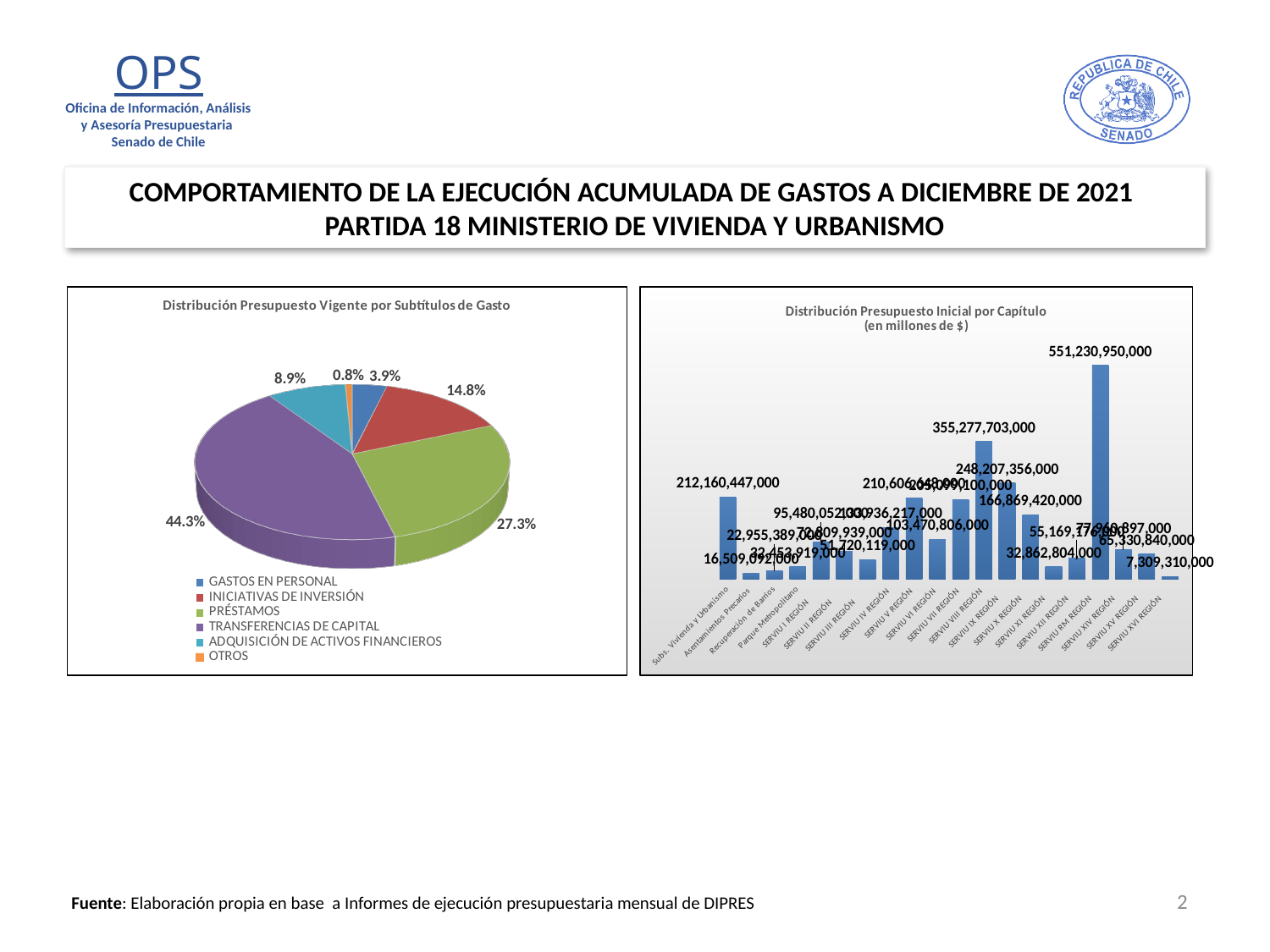
In the bar chart 'Distribución Presupuesto Inicial por Capítulo', what is the value of the highest bar? 551,230,950,000 In the pie chart 'Distribución Presupuesto Vigente por Subtítulos de Gasto', which is larger: GASTOS EN PERSONAL or ADQUISICIÓN DE ACTIVOS FINANCIEROS? ADQUISICIÓN DE ACTIVOS FINANCIEROS What kind of chart is 'Distribución Presupuesto Inicial por Capítulo'? Bar chart In the pie chart 'Distribución Presupuesto Vigente por Subtítulos de Gasto', what share does PRÉSTAMOS have? 27.3% In the pie chart 'Distribución Presupuesto Vigente por Subtítulos de Gasto', which category has the smallest share? OTROS In the pie chart 'Distribución Presupuesto Vigente por Subtítulos de Gasto', what share does TRANSFERENCIAS DE CAPITAL have? 44.3% In the pie chart 'Distribución Presupuesto Vigente por Subtítulos de Gasto', which category has the largest share? TRANSFERENCIAS DE CAPITAL In the pie chart 'Distribución Presupuesto Vigente por Subtítulos de Gasto', what is the difference in percentage points between PRÉSTAMOS and INICIATIVAS DE INVERSIÓN? 12.5 In the pie chart 'Distribución Presupuesto Vigente por Subtítulos de Gasto', how many categories does the legend list? 6 In the pie chart 'Distribución Presupuesto Vigente por Subtítulos de Gasto', what share does INICIATIVAS DE INVERSIÓN have? 14.8% In the bar chart 'Distribución Presupuesto Inicial por Capítulo', which capítulo has the highest value? SERVIU RM REGIÓN In the bar chart 'Distribución Presupuesto Inicial por Capítulo', what is the value for Subs. Vivienda y Urbanismo? 212,160,447,000